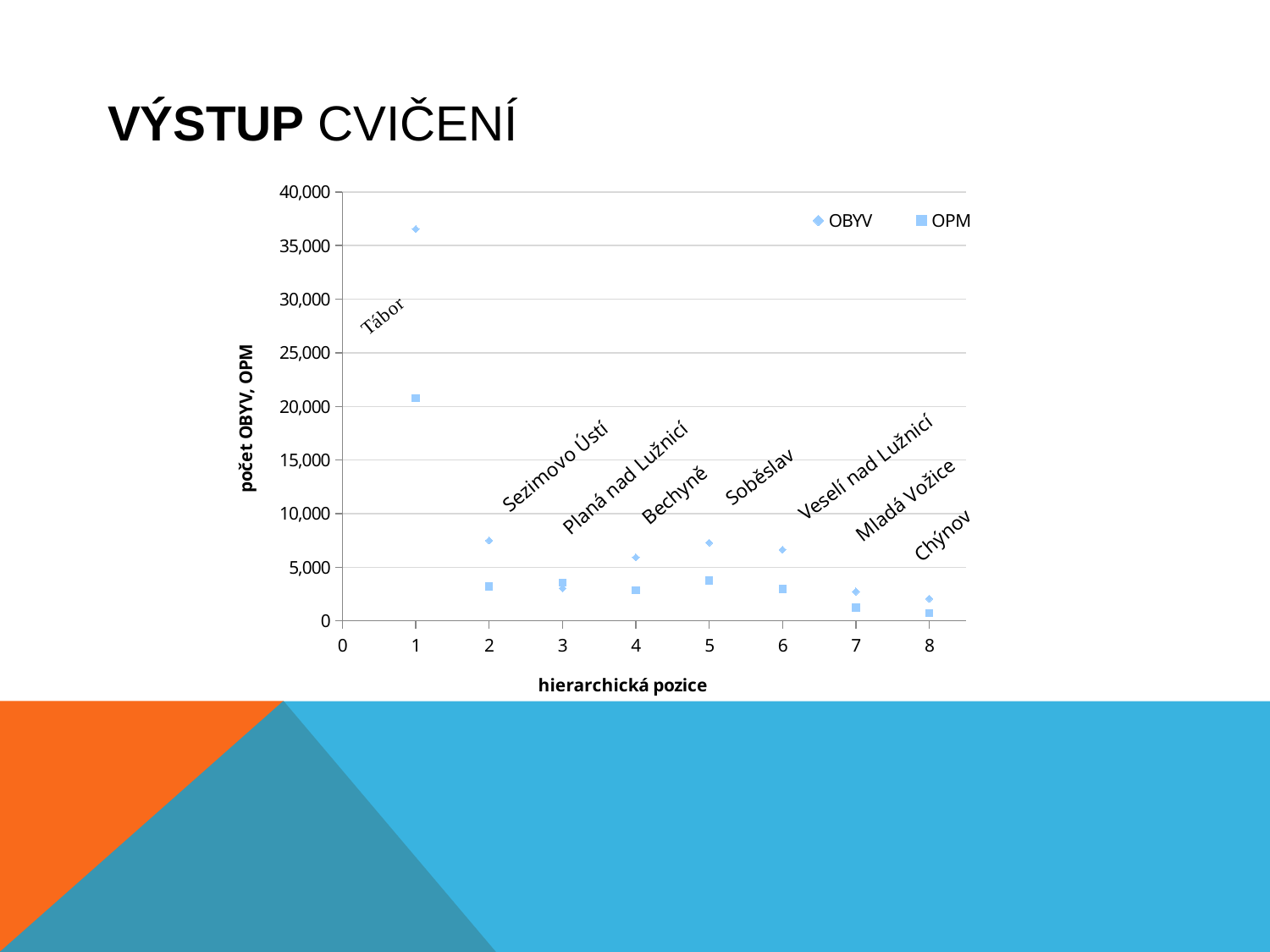
Is the OBYV value at hierarchical position 2 greater or less than 10,000? less What is the title of the x axis? hierarchická pozice What are the two series named in the legend? OBYV and OPM At which hierarchical position is the OBYV value highest? 1 At which hierarchical position is the OPM value lowest? 8 Is the OPM value at hierarchical position 1 greater or less than 25,000? less How many hierarchical positions have data points plotted? 8 Is the OBYV value at hierarchical position 1 greater or less than 35,000? greater At hierarchical position 1, which series has the larger value, OBYV or OPM? OBYV How many series does the legend list? 2 What kind of chart is shown on the slide? scatter chart